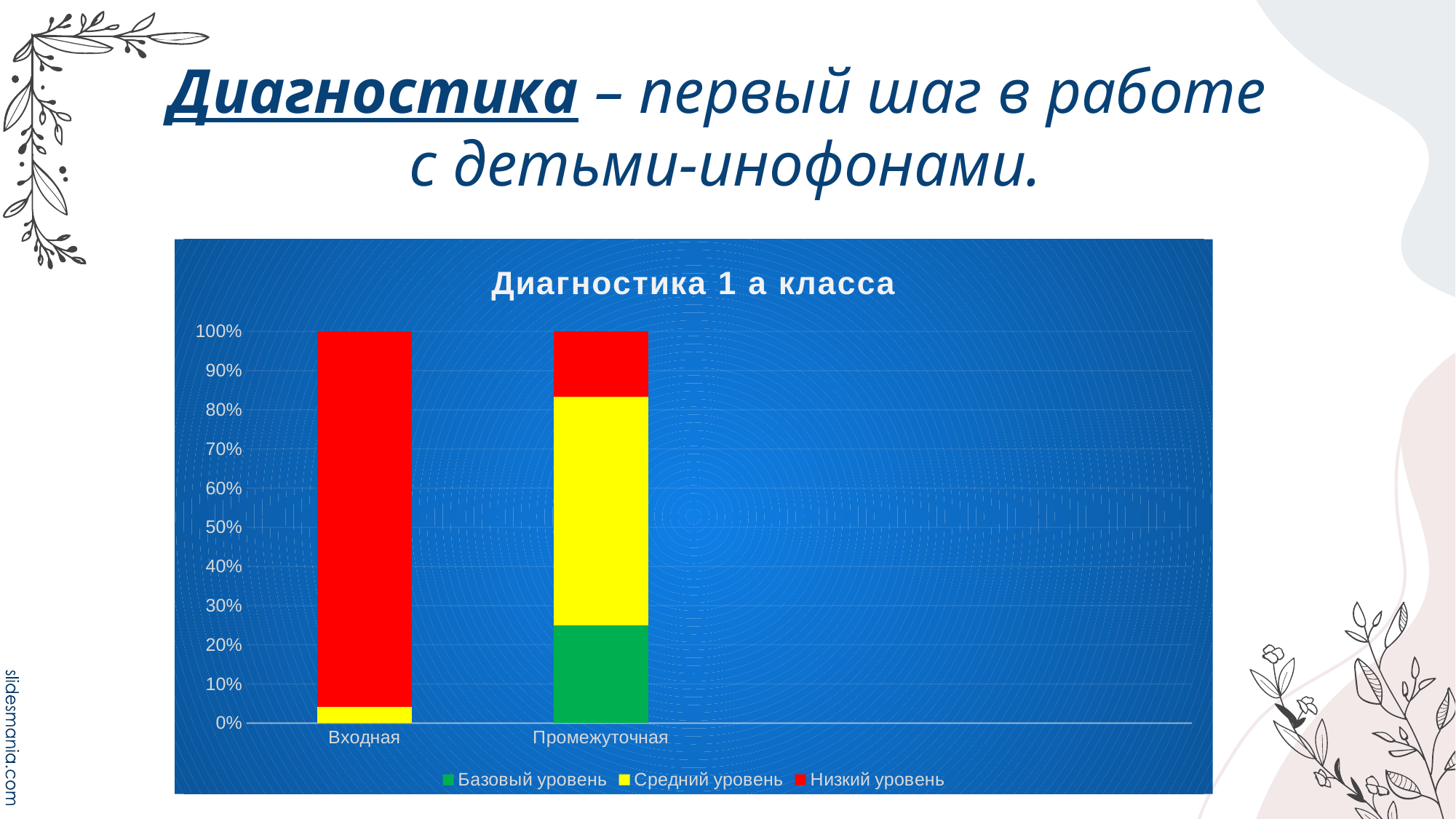
Which colour represents Низкий уровень in the chart? Red Is the Средний уровень share for Входная greater or less than 10%? less Does the Низкий уровень share rise or fall from Входная to Промежуточная? Fall How many categories are shown on the x axis of the chart? 2 What is the title of the chart? Диагностика 1 а класса Which category has the larger Низкий уровень share, Входная or Промежуточная? Входная Which category has the larger Средний уровень share, Входная or Промежуточная? Промежуточная What kind of chart is shown on the slide? Stacked bar chart Is the Низкий уровень share for Входная greater or less than 90%? greater Is the Средний уровень share for Промежуточная greater or less than 50%? greater How many series does the chart legend list? 3